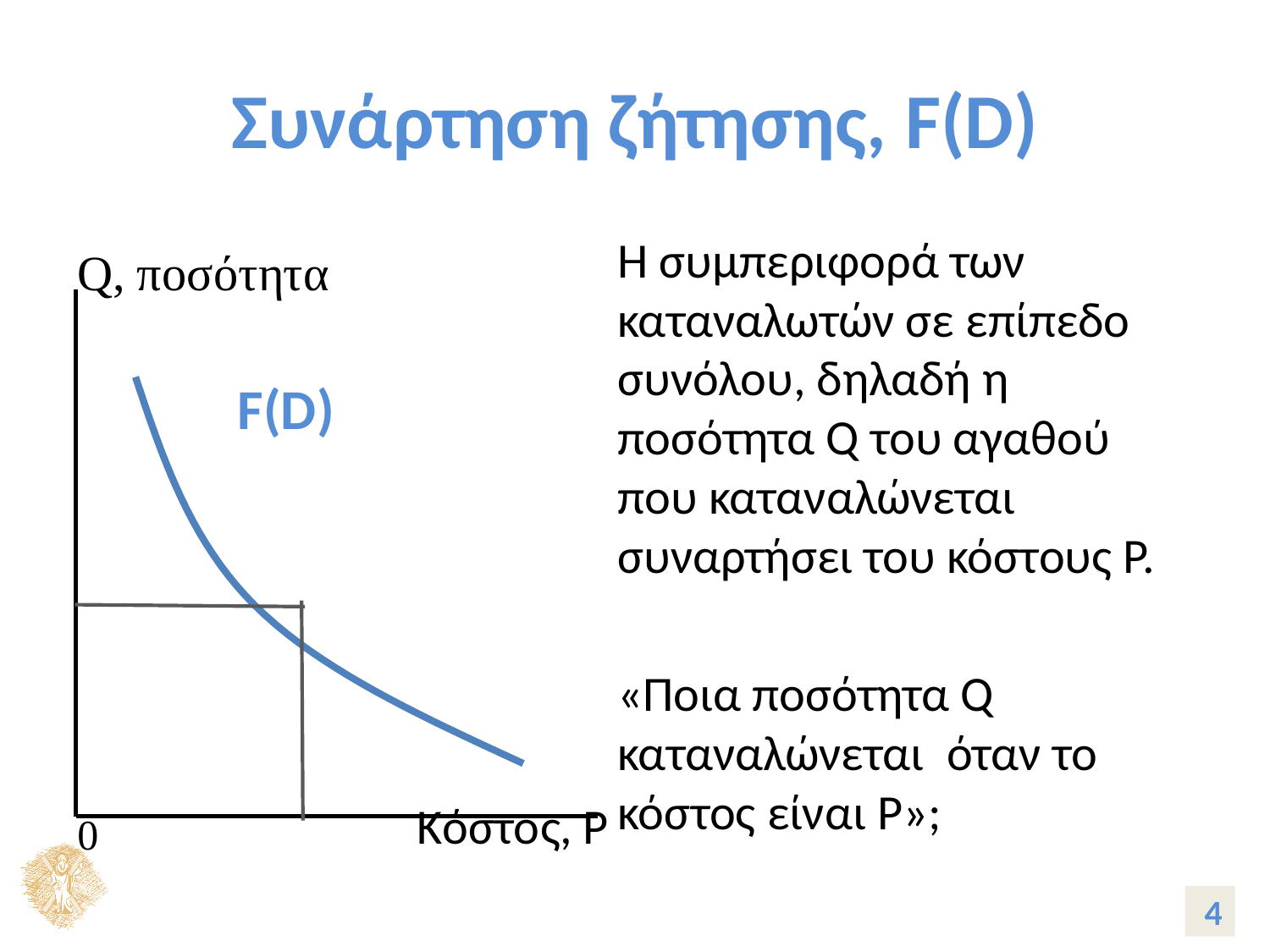
What kind of chart is shown on the slide? line chart What is the label of the vertical axis of the chart? Q, ποσότητα What is the label of the curve plotted on the chart? F(D) Does the curve F(D) rise or fall as the value on the x axis (Κόστος, P) increases? fall How many curves are plotted on the chart? 1